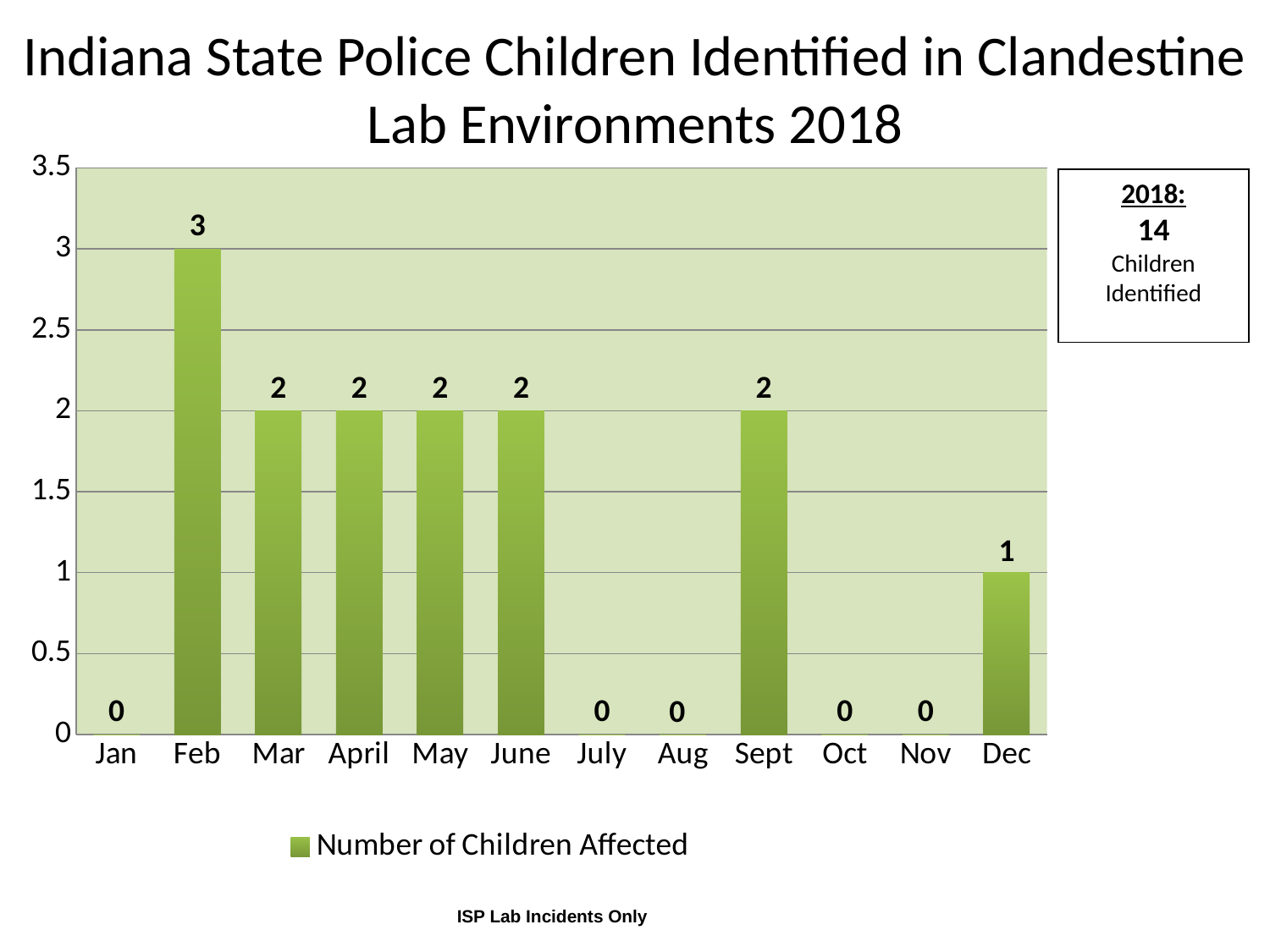
What kind of chart is shown on the slide? bar chart Which is larger, the value for March or the value for December? March Is the value for February greater or less than 2.5? greater What is the difference between the values for February and December? 2 How many series does the legend list? 1 What is the legend entry for the series? Number of Children Affected Which month has the highest number of children affected? Feb How many children were identified in February? 3 How many months are shown on the x axis? 12 What is the value for December? 1 What is the value for September? 2 How many months have a value of 0? 5